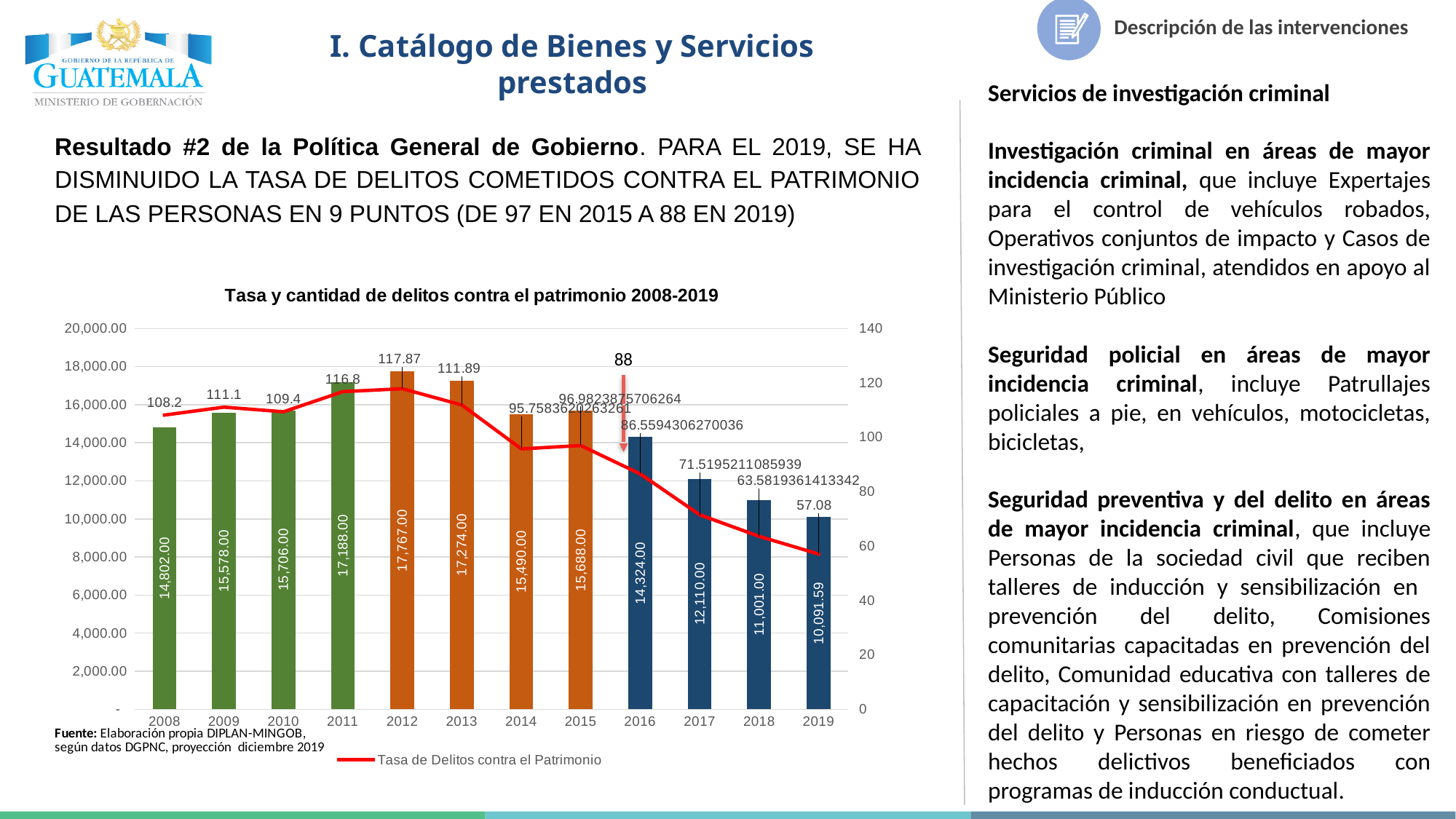
What is the value of the Tasa de Delitos contra el Patrimonio line for 2011? 116.8 Which year has the highest bar value? 2012 What is the value of the Tasa de Delitos contra el Patrimonio line for 2019? 57.08 Which is larger, the bar value for 2009 or for 2010? 2010 What is the bar value for 2019? 10,091.59 How many years are shown on the x axis? 12 Does the Tasa de Delitos contra el Patrimonio line rise or fall from 2013 to 2019? fall What is the title of the chart? Tasa y cantidad de delitos contra el patrimonio 2008-2019 What is the difference between the bar values for 2012 and 2013? 493.00 Which year has the lowest bar value? 2019 How many series does the legend list? 1 What is the bar value for 2012? 17,767.00